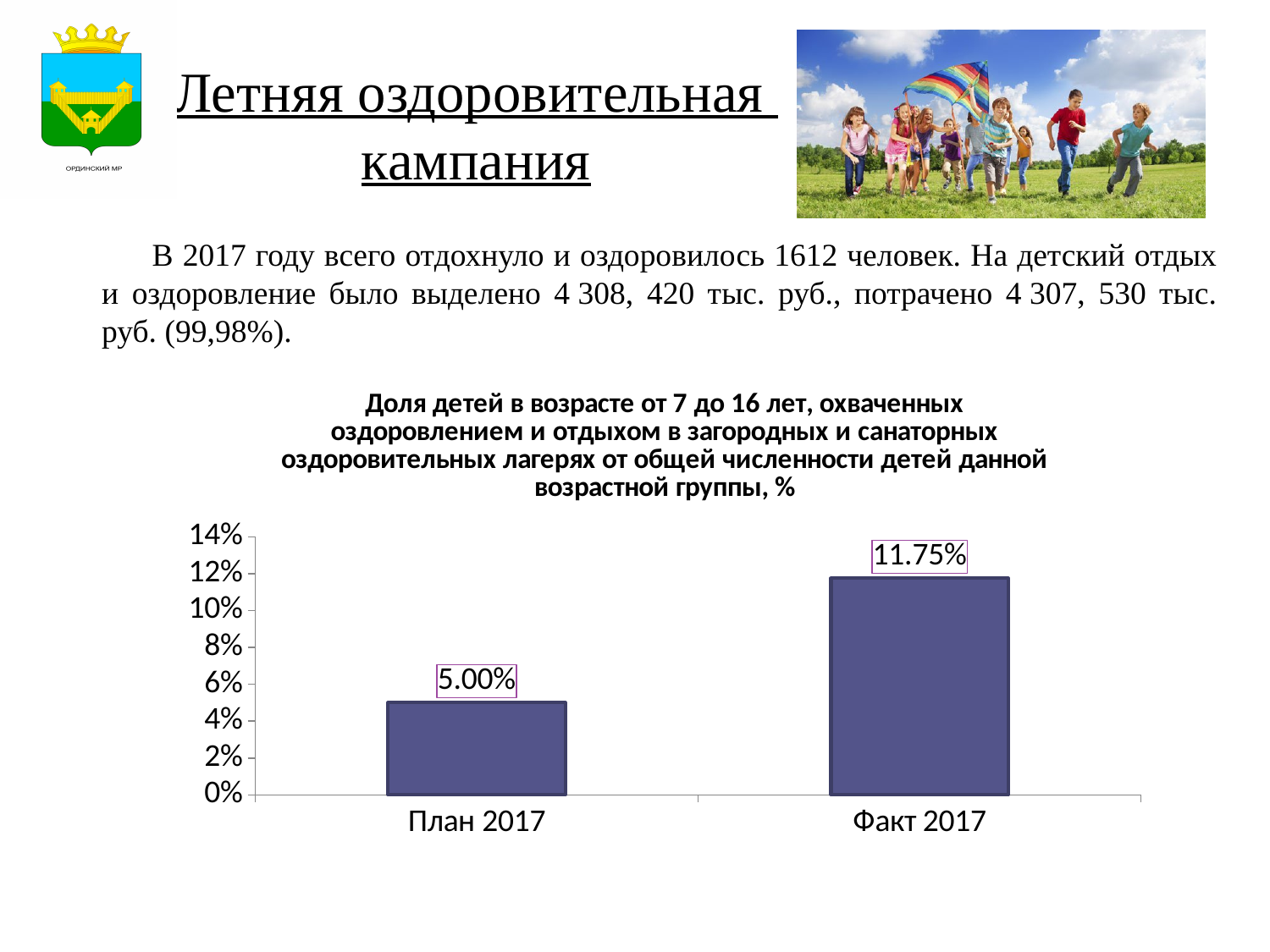
Which is larger, the value for План 2017 or the value for Факт 2017? Факт 2017 What kind of chart is shown on the slide? bar chart Which category has the highest value? Факт 2017 What is the difference between the values for Факт 2017 and План 2017? 6.75% Is the value for План 2017 greater or less than 6%? less Is the value for Факт 2017 greater or less than 10%? greater Which category has the lowest value? План 2017 What is the value for План 2017? 5.00% What is the value for Факт 2017? 11.75% What is the maximum value shown on the vertical axis? 14% Do the values rise or fall from План 2017 to Факт 2017? rise How many categories are shown on the x axis? 2